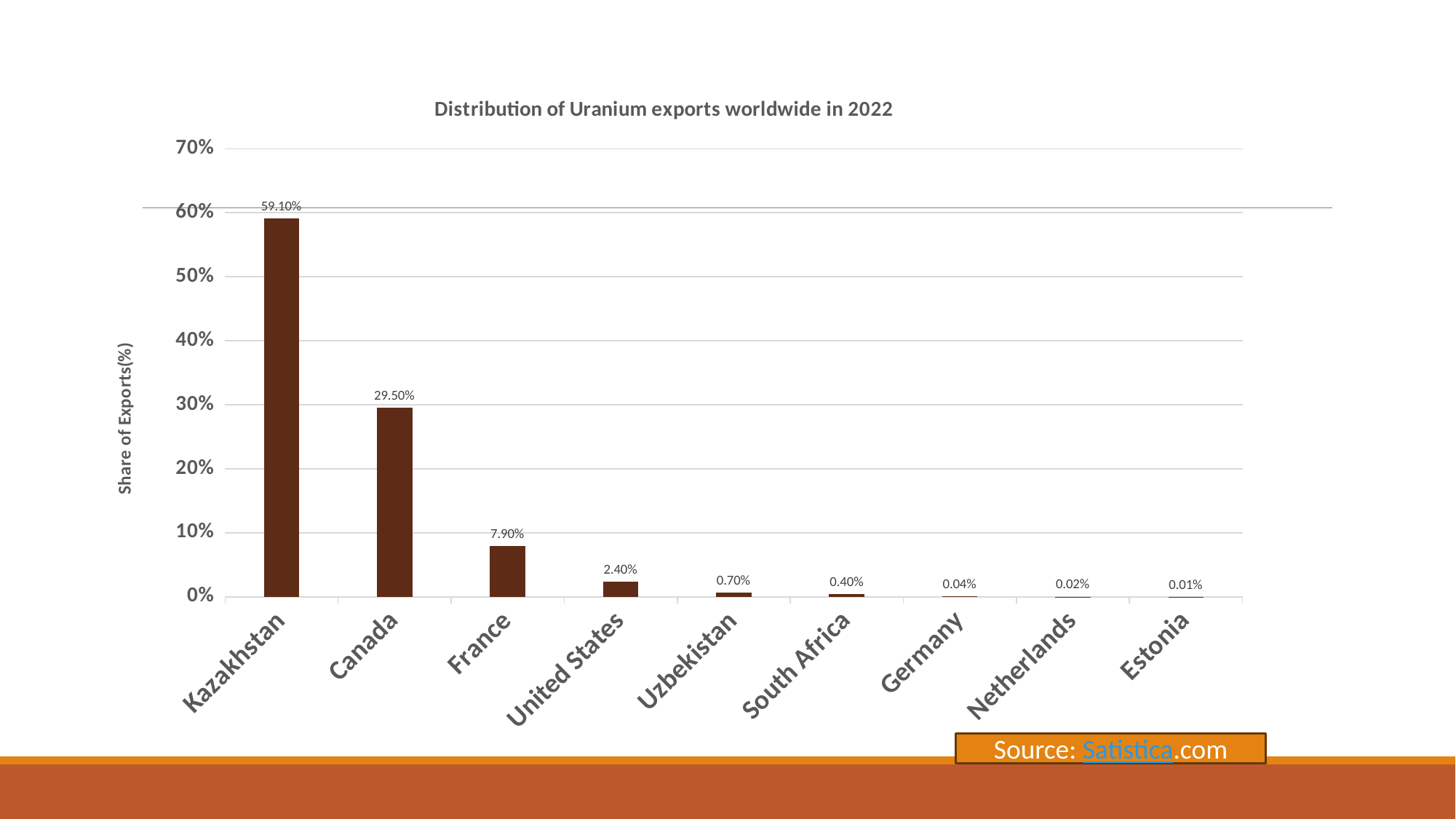
What is the difference between Kazakhstan's and Canada's share of uranium exports? 29.60% What kind of chart is shown on the slide? Bar chart What is the share of uranium exports for Canada? 29.50% Which country has the lowest share of uranium exports? Estonia What is the share of uranium exports for Estonia? 0.01% What is the title of the chart? Distribution of Uranium exports worldwide in 2022 How many countries are shown in the chart? 9 Which has a larger share of uranium exports, Uzbekistan or South Africa? Uzbekistan What is the share of uranium exports for France? 7.90% What is the share of uranium exports for the United States? 2.40% What is the share of uranium exports for Kazakhstan? 59.10% Which country has the highest share of uranium exports? Kazakhstan